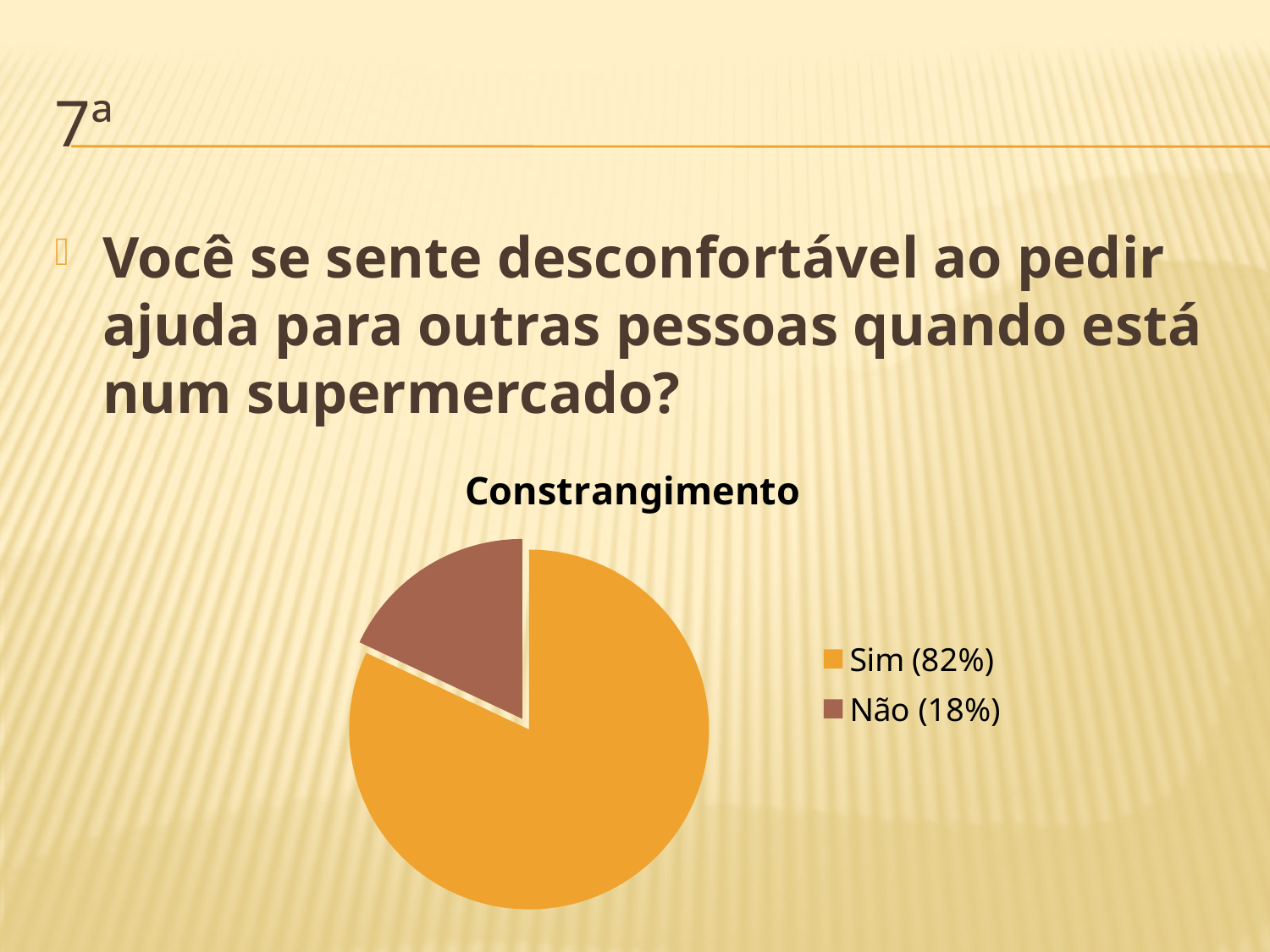
What share of the pie does the 'Não' slice represent? 18% What kind of chart is shown on the slide? pie chart Is the share for 'Não' greater or less than 50%? less Which slice is the smallest in the pie chart? Não What is the difference in percentage points between the 'Sim' and 'Não' slices? 64 How many slices does the pie chart have? 2 Which slice is the largest in the pie chart? Sim Which is larger, the 'Sim' slice or the 'Não' slice? Sim How many entries does the legend list? 2 What share of the pie does the 'Sim' slice represent? 82% What colour is the 'Sim' slice in the pie chart? orange What is the title of the chart? Constrangimento